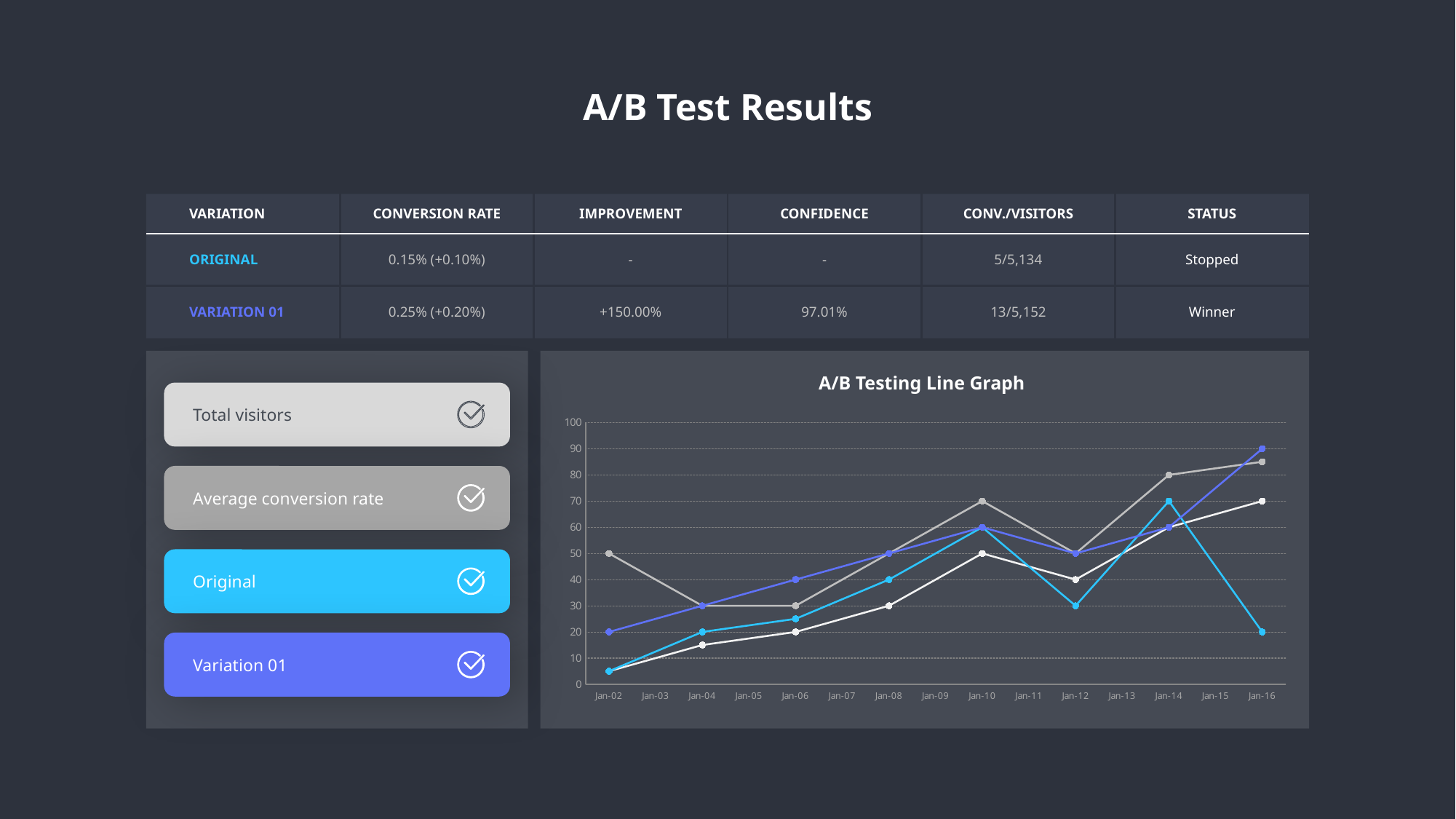
What kind of chart is the A/B Testing Line Graph? Line chart In the A/B Testing Line Graph, what is the value for Original at Jan-16? 20 In the A/B Testing Line Graph, which series has the lowest value at Jan-16? Original In the A/B Testing Line Graph, what is the value for Variation 01 at Jan-16? 90 In the A/B Testing Line Graph, what is the value for Original at Jan-14? 70 How many series are shown in the A/B Testing Line Graph? 4 In the A/B Testing Line Graph, what is the difference between Variation 01 and Original at Jan-16? 70 In the A/B Testing Line Graph, does the Variation 01 line rise or fall from Jan-02 to Jan-10? Rise In the A/B Testing Line Graph, which is larger at Jan-12: Variation 01 or Original? Variation 01 In the A/B Testing Line Graph, which series has the highest value at Jan-16? Variation 01 In the A/B Testing Line Graph, is the value for Average conversion rate at Jan-16 greater or less than 80? greater How many labels are on the x axis of the A/B Testing Line Graph? 15